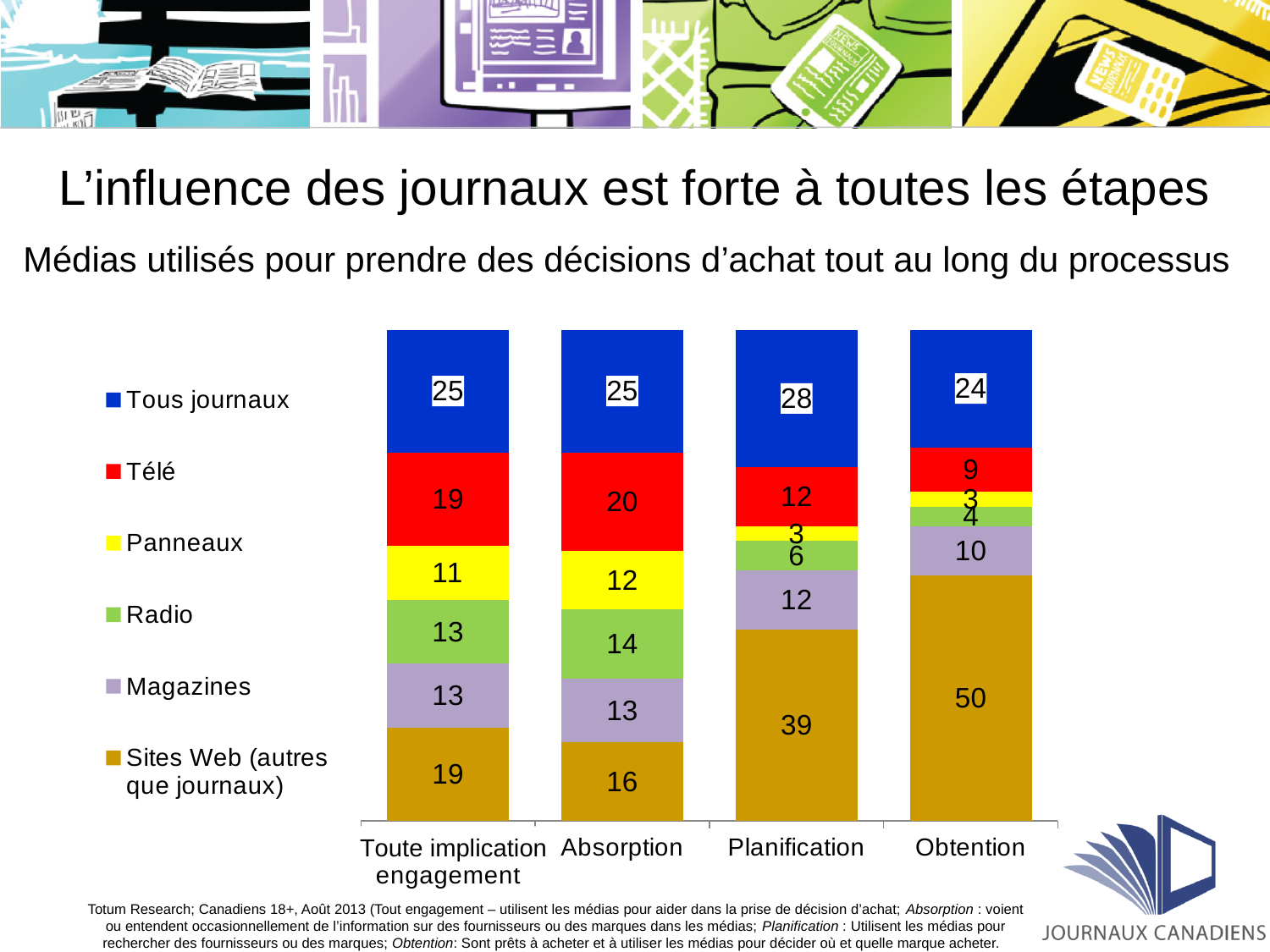
What is the value for Tous journaux in the Planification category? 28 In which category is the value for Télé lowest? Obtention In which category is the value for Sites Web (autres que journaux) highest? Obtention What is the value for Sites Web (autres que journaux) in the Obtention category? 50 Which colour represents Panneaux in the legend? yellow What is the value for Télé in the Absorption category? 20 How many categories are shown along the x axis? 4 Which is larger: the Radio value for Absorption or the Radio value for Planification? Absorption How many series does the legend list? 6 What kind of chart is shown on the slide? stacked bar chart What is the total of the stacked bar for Planification? 100 What is the difference between the Sites Web (autres que journaux) values for Obtention and Toute implication engagement? 31